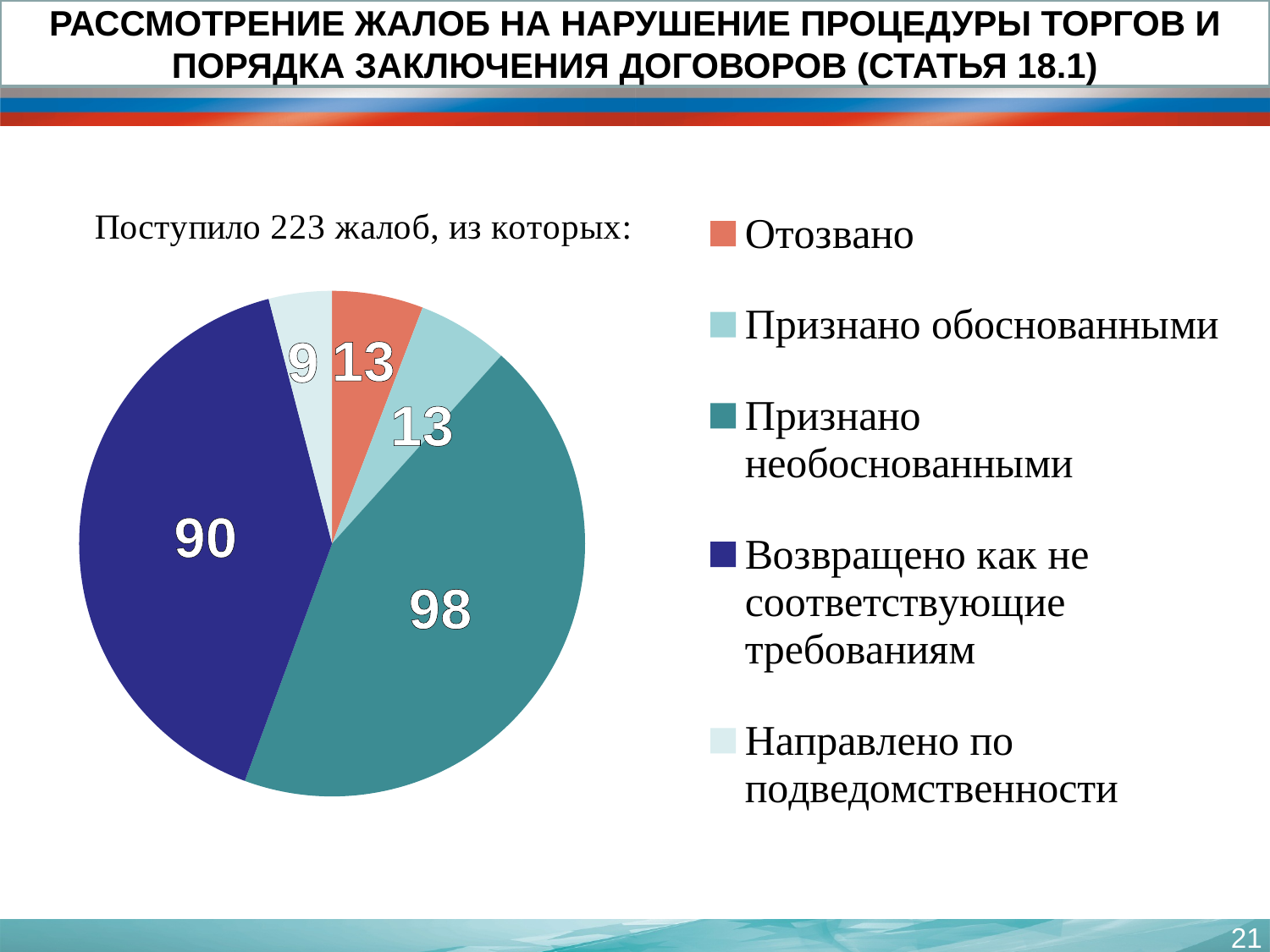
Which is larger: the value for "Признано обоснованными" or the value for "Направлено по подведомственности"? Признано обоснованными What is the value for "Отозвано"? 13 What is the value for "Направлено по подведомственности"? 9 What is the value for "Признано необоснованными"? 98 What is the difference between the values for "Признано необоснованными" and "Возвращено как не соответствующие требованиям"? 8 Which category has the smallest slice of the pie? Направлено по подведомственности What type of chart is shown on the slide? Pie chart How many slices does the pie chart have? 5 What is the value for "Возвращено как не соответствующие требованиям"? 90 Which category has the largest slice of the pie? Признано необоснованными According to the text above the chart, how many complaints were received in total? 223 How many entries does the legend list? 5